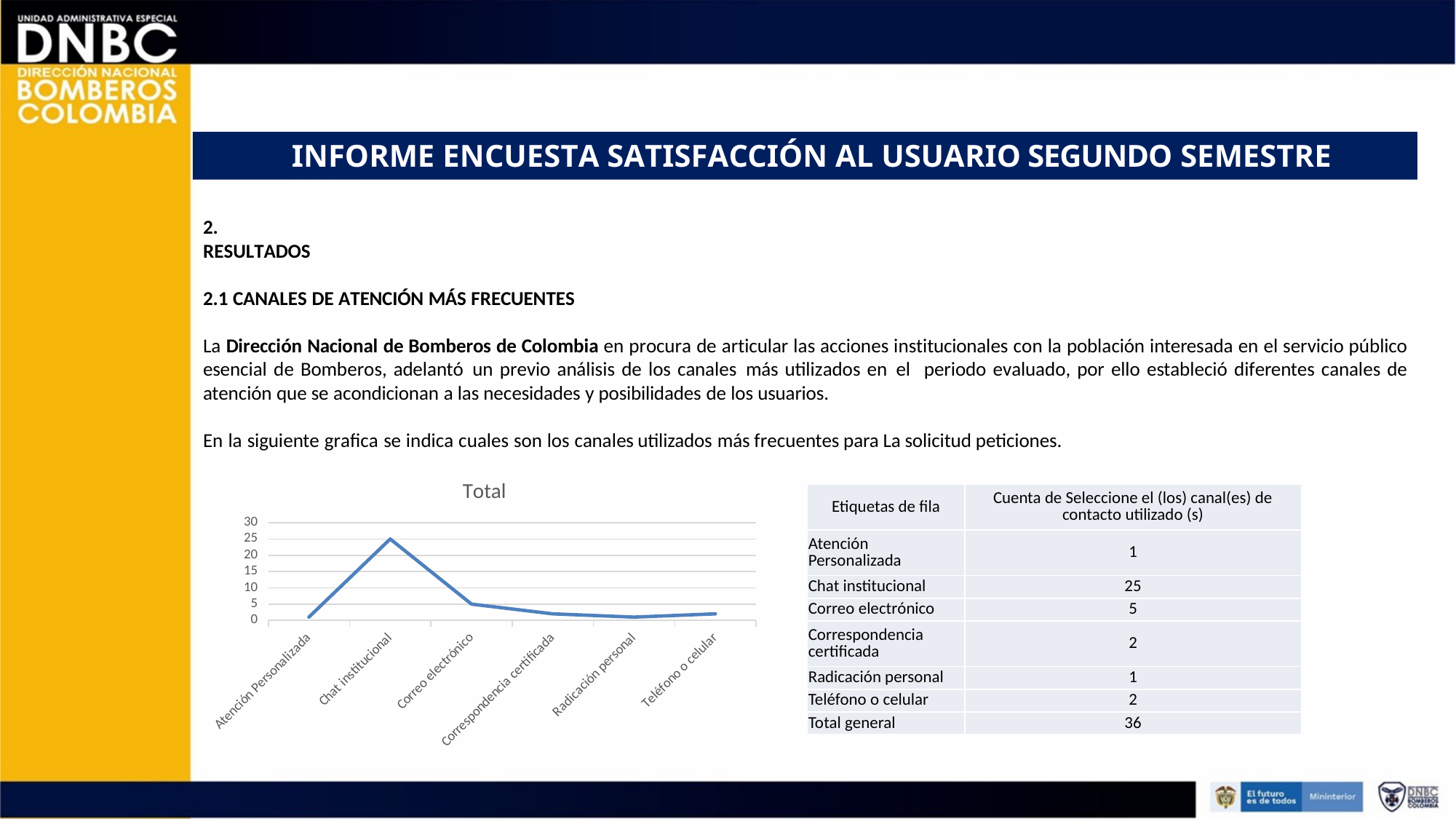
Which is larger, the value for Chat institucional or the value for Correo electrónico? Chat institucional Do the values rise or fall from Chat institucional to Radicación personal? fall What is the value for Chat institucional? 25 Is the value for Chat institucional greater or less than 20? greater What kind of chart is shown on the slide? line chart Is the value for Correspondencia certificada greater or less than 5? less What is the difference between the values for Chat institucional and Correo electrónico? 20 Which category has the highest value in the chart? Chat institucional How many categories are plotted along the x axis of the chart? 6 What is the value for Correo electrónico? 5 What is the value for Atención Personalizada? 1 What is the title of the chart? Total